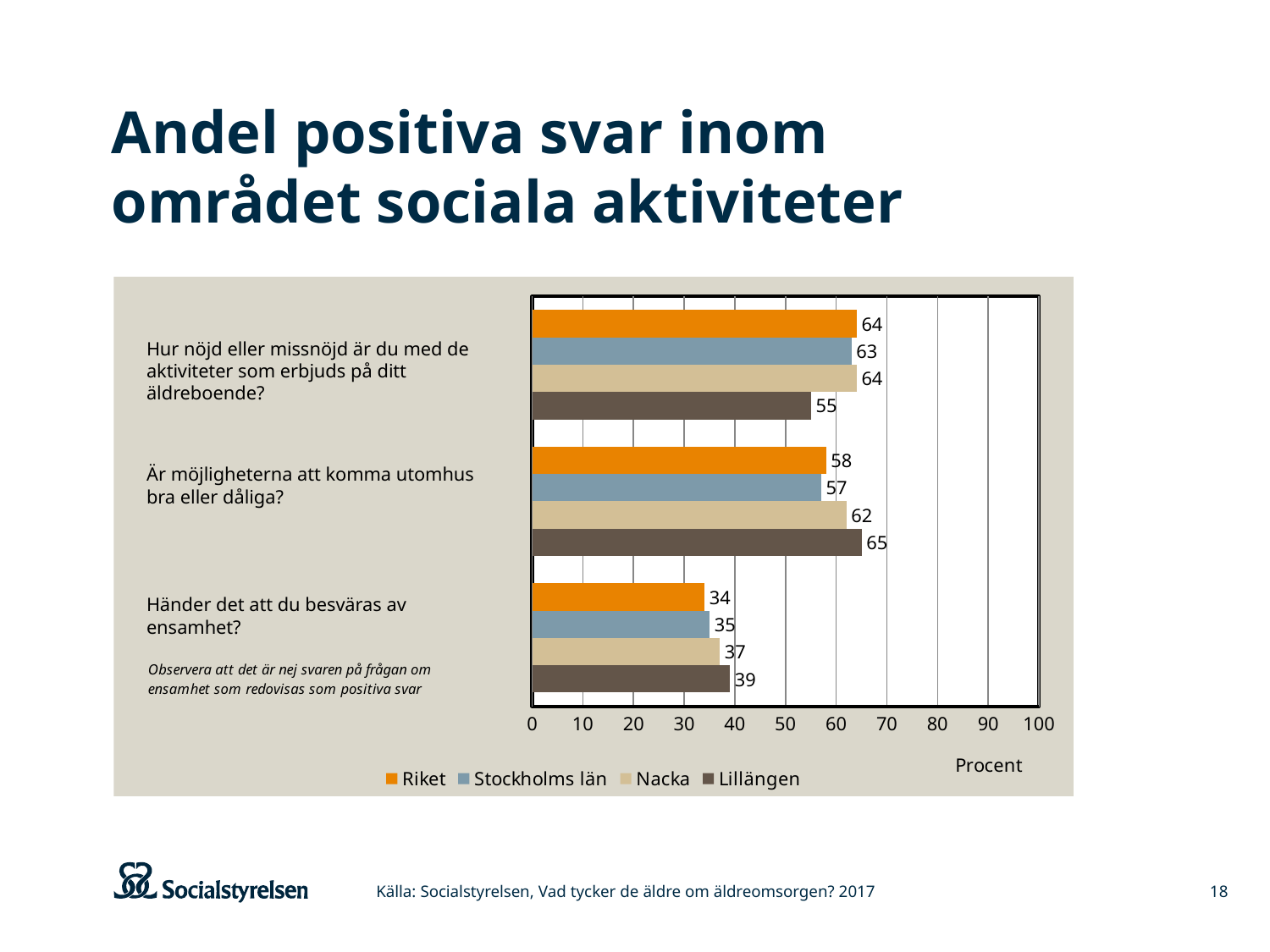
What is the value for Riket on the question "Händer det att du besväras av ensamhet?"? 34 What is the value for Lillängen on the question "Hur nöjd eller missnöjd är du med de aktiviteter som erbjuds på ditt äldreboende?"? 55 How many series does the legend list? 4 How many questions (categories) are shown on the chart? 3 Which series has the lowest value on the question "Hur nöjd eller missnöjd är du med de aktiviteter som erbjuds på ditt äldreboende?"? Lillängen What is the value for Nacka on the question "Är möjligheterna att komma utomhus bra eller dåliga?"? 62 What is the difference between Lillängen and Riket on the question "Är möjligheterna att komma utomhus bra eller dåliga?"? 7 Which is larger on the question "Händer det att du besväras av ensamhet?": Nacka or Stockholms län? Nacka What is the difference between Lillängen and Riket on the question "Händer det att du besväras av ensamhet?"? 5 Is the value for Lillängen on the question "Hur nöjd eller missnöjd är du med de aktiviteter som erbjuds på ditt äldreboende?" greater or less than 60? less Which series has the highest value on the question "Är möjligheterna att komma utomhus bra eller dåliga?"? Lillängen What kind of chart is shown on the slide? Bar chart